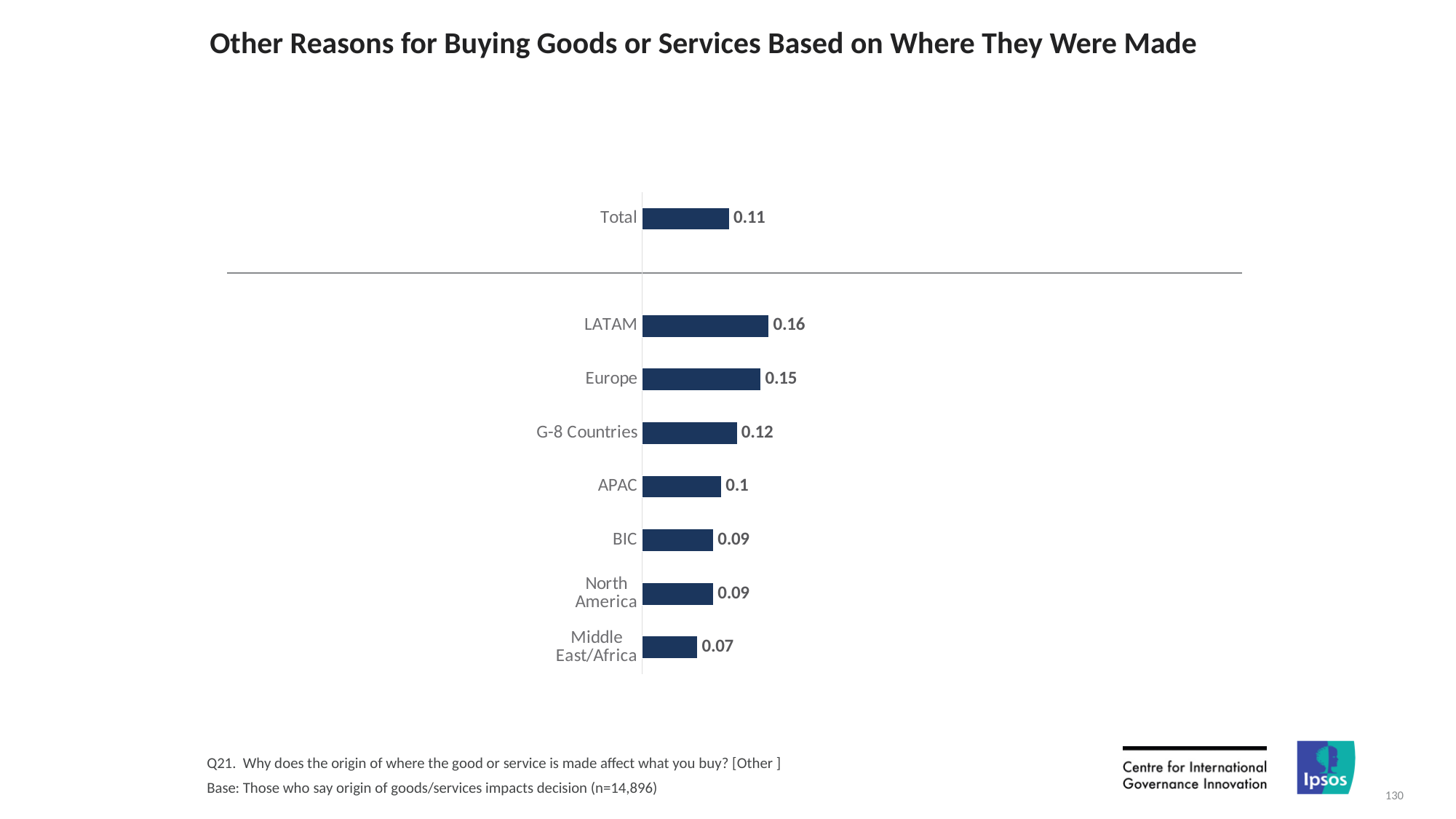
What kind of chart is shown on the slide? Bar chart What is the value for LATAM? 0.16 What is the value for G-8 Countries? 0.12 What is the value for Middle East/Africa? 0.07 What is the value for Total? 0.11 Which region has the highest value? LATAM What is the title of the chart? Other Reasons for Buying Goods or Services Based on Where They Were Made Which region has the lowest value? Middle East/Africa How many bars are shown on the chart, including Total? 8 What is the difference between the values for Europe and Middle East/Africa? 0.08 Which is larger, the value for G-8 Countries or the value for APAC? G-8 Countries What is the difference between the values for LATAM and Europe? 0.01